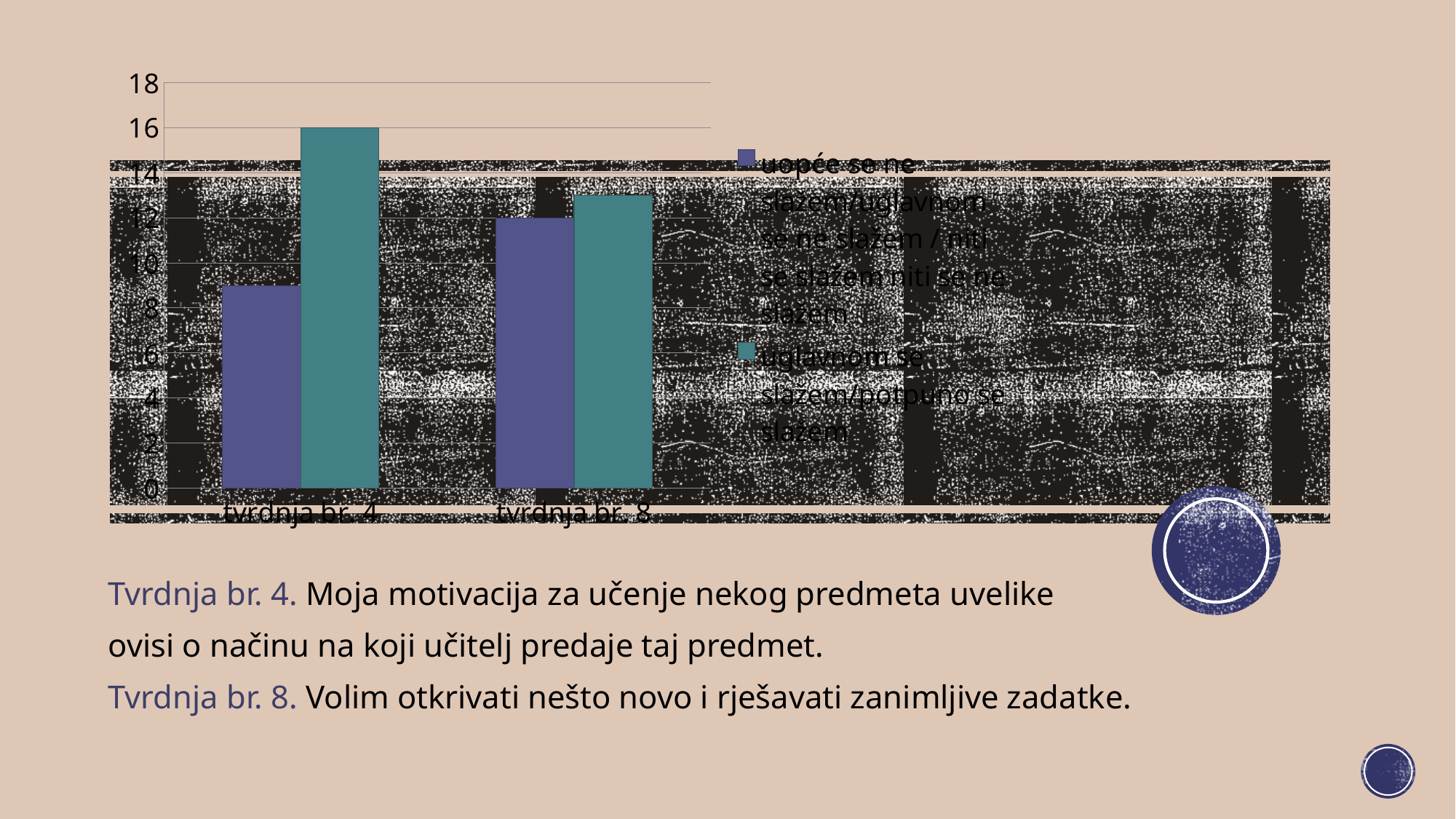
What is the value of the 'uglavnom se slažem/potpuno se slažem' bar for tvrdnja br. 4? 16 How many series does the chart's legend list? 2 Which bar in the chart is the shortest? uopće se ne slažem/uglavnom se ne slažem / niti se slažem niti se ne slažem for tvrdnja br. 4 What is the value of the 'uopće se ne slažem/uglavnom se ne slažem / niti se slažem niti se ne slažem' bar for tvrdnja br. 8? 12 Which bar in the chart is the tallest? uglavnom se slažem/potpuno se slažem for tvrdnja br. 4 What is the difference between the 'uglavnom se slažem/potpuno se slažem' value for tvrdnja br. 4 and the 'uopće se ne slažem/uglavnom se ne slažem / niti se slažem niti se ne slažem' value for tvrdnja br. 8? 4 How many categories are shown on the x axis of the chart? 2 Is the value of the 'uglavnom se slažem/potpuno se slažem' bar for tvrdnja br. 8 greater or less than 12? greater What colour are the bars for the 'uglavnom se slažem/potpuno se slažem' series? teal Is the value of the 'uopće se ne slažem/uglavnom se ne slažem / niti se slažem niti se ne slažem' bar for tvrdnja br. 4 greater or less than 10? less What kind of chart is shown on the slide? bar chart For tvrdnja br. 4, which series has the larger value: 'uglavnom se slažem/potpuno se slažem' or 'uopće se ne slažem/uglavnom se ne slažem / niti se slažem niti se ne slažem'? uglavnom se slažem/potpuno se slažem